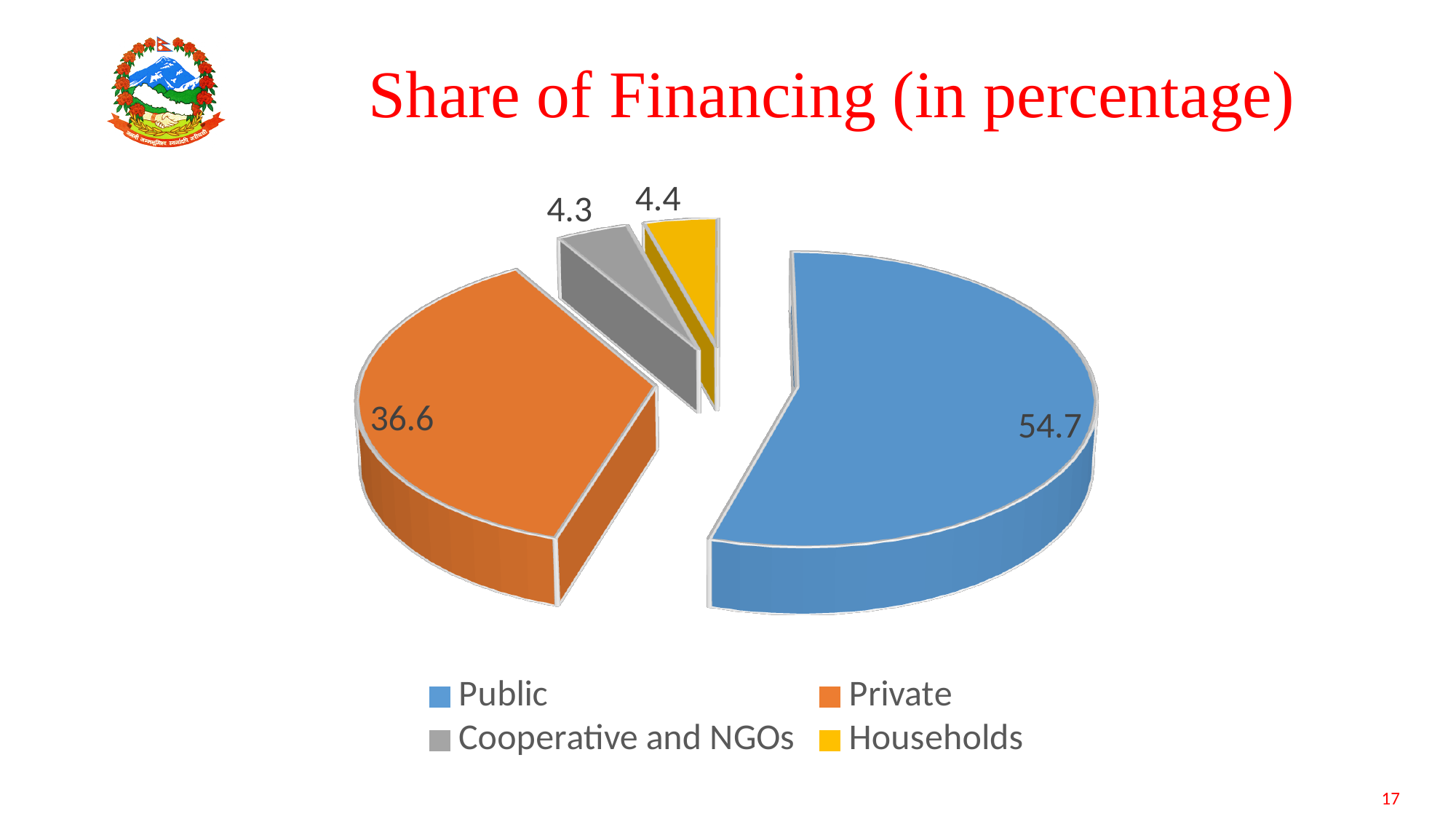
What type of chart is shown on the slide? Pie chart Which category has the smallest share of financing? Cooperative and NGOs What is the value for Households? 4.4 Which is larger, the value for Private or the value for Households? Private How many categories does the pie chart show? 4 What colour is the Households slice? Yellow What is the value for Cooperative and NGOs? 4.3 Which category has the largest share of financing? Public What is the value for Private? 36.6 What is the difference between the Public and Private values? 18.1 What is the value for Public? 54.7 What is the title of the chart? Share of Financing (in percentage)